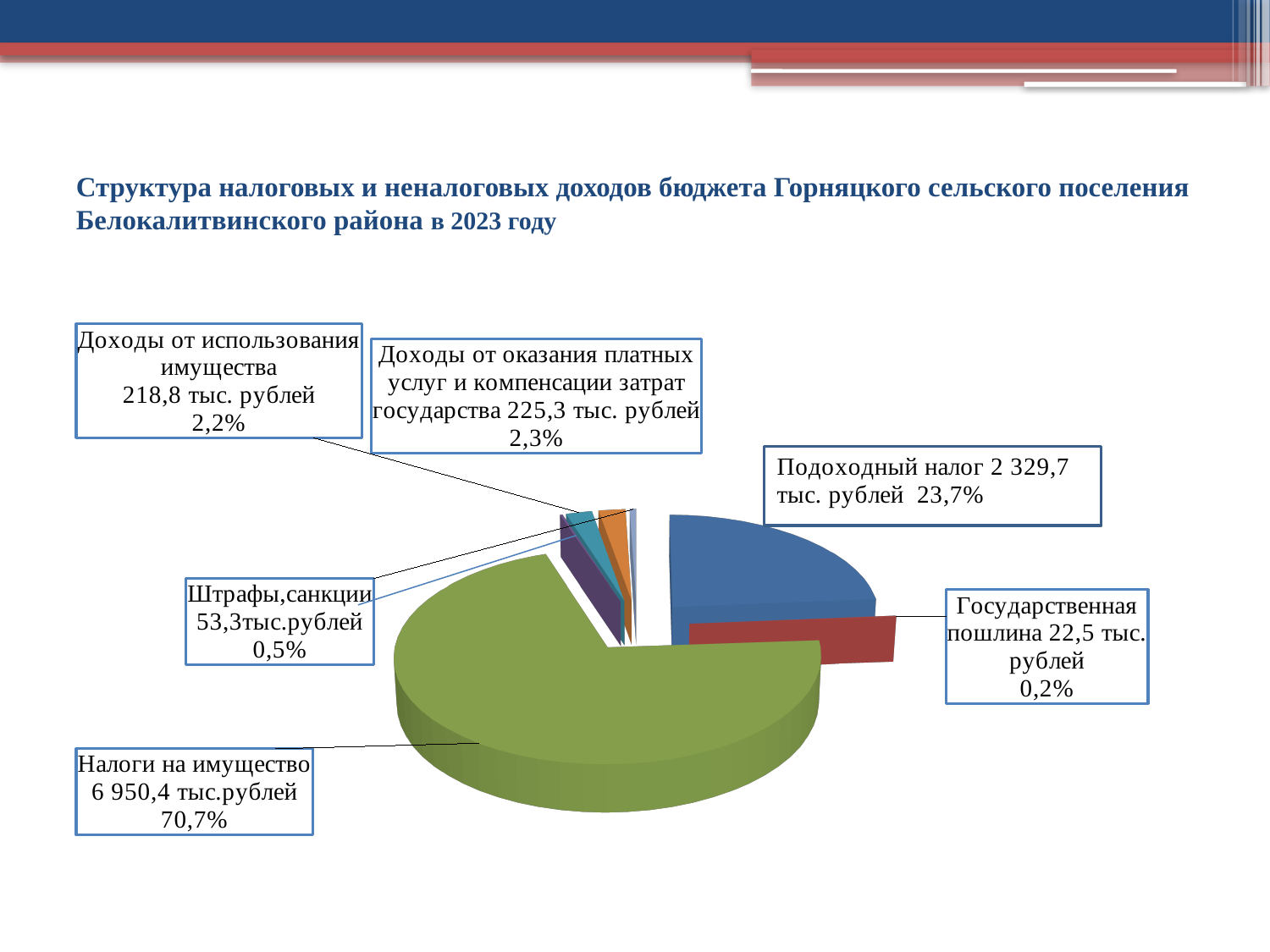
What is the value for Государственная пошлина? 22,5 тыс. рублей How many slices (categories) does the pie chart have? 7 What kind of chart is shown on the slide? Pie chart What is the value for Налоги на имущество? 6 950,4 тыс.рублей Which category has the largest slice of the pie? Налоги на имущество What share of the pie does Налоги на имущество represent? 70,7% What is the value for Подоходный налог? 2 329,7 тыс. рублей What year does the chart title refer to? 2023 What share of the pie does Штрафы,санкции represent? 0,5% Which is larger: Подоходный налог or Доходы от использования имущества? Подоходный налог What is the difference between the values for Налоги на имущество and Подоходный налог? 4 620,7 тыс. рублей